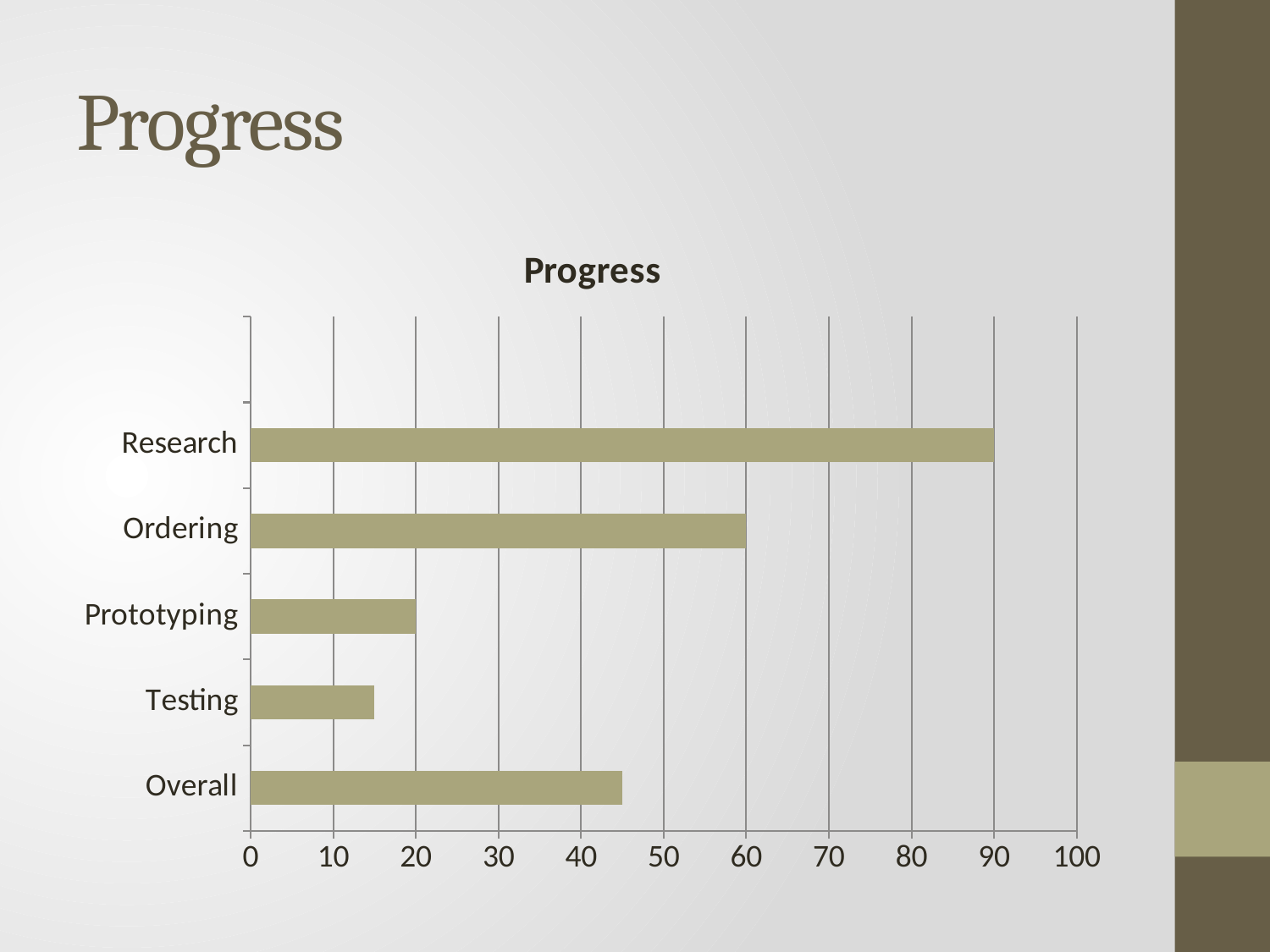
Is the value for Testing greater or less than 20? less What is the value for Ordering? 60 What is the title of the chart? Progress How many labeled categories are shown on the chart? 5 What is the difference between the values for Research and Ordering? 30 Which is larger, the value for Overall or the value for Prototyping? Overall Which category has the highest value? Research What is the value for Prototyping? 20 Is the value for Overall greater or less than 40? greater Which category has the lowest value? Testing What type of chart is shown on the slide? bar chart What is the value for Research? 90